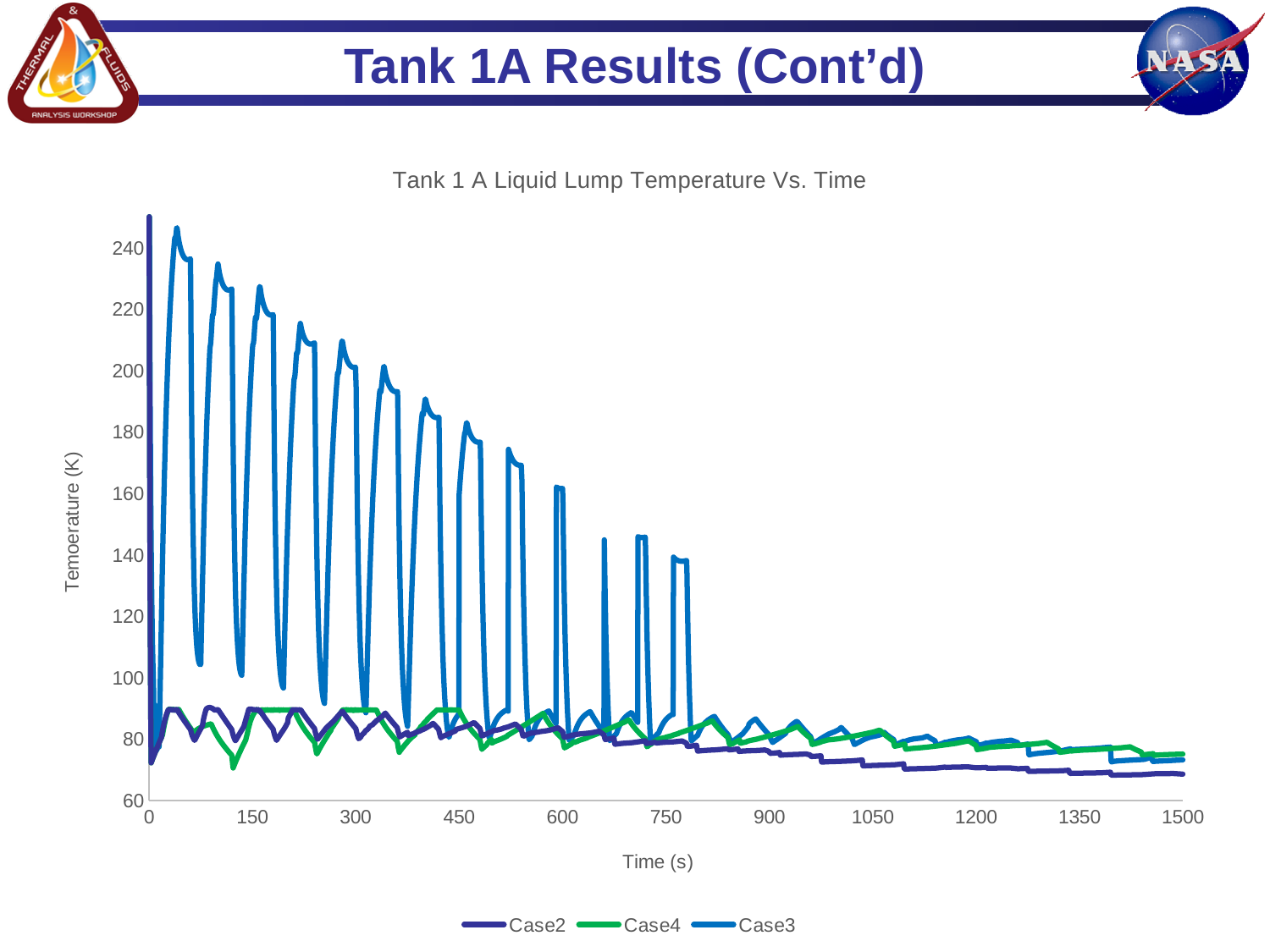
Is the Case3 peak near 750 s greater or less than 160? less How many series does the legend list? 3 Do the peaks of Case3 rise or fall as time increases? fall Is the first peak of Case3 (near 40 s) greater or less than 200? greater Which series reaches the highest temperature on the chart? Case3 Is the value of Case2 at 1500 s greater or less than 80? less What is the title of the chart? Tank 1 A Liquid Lump Temperature Vs. Time What is the label of the x axis? Time (s) What kind of chart is shown on the slide? Line chart How many tick labels are shown on the x axis? 11 At 1500 s, which series has the higher value, Case2 or Case4? Case4